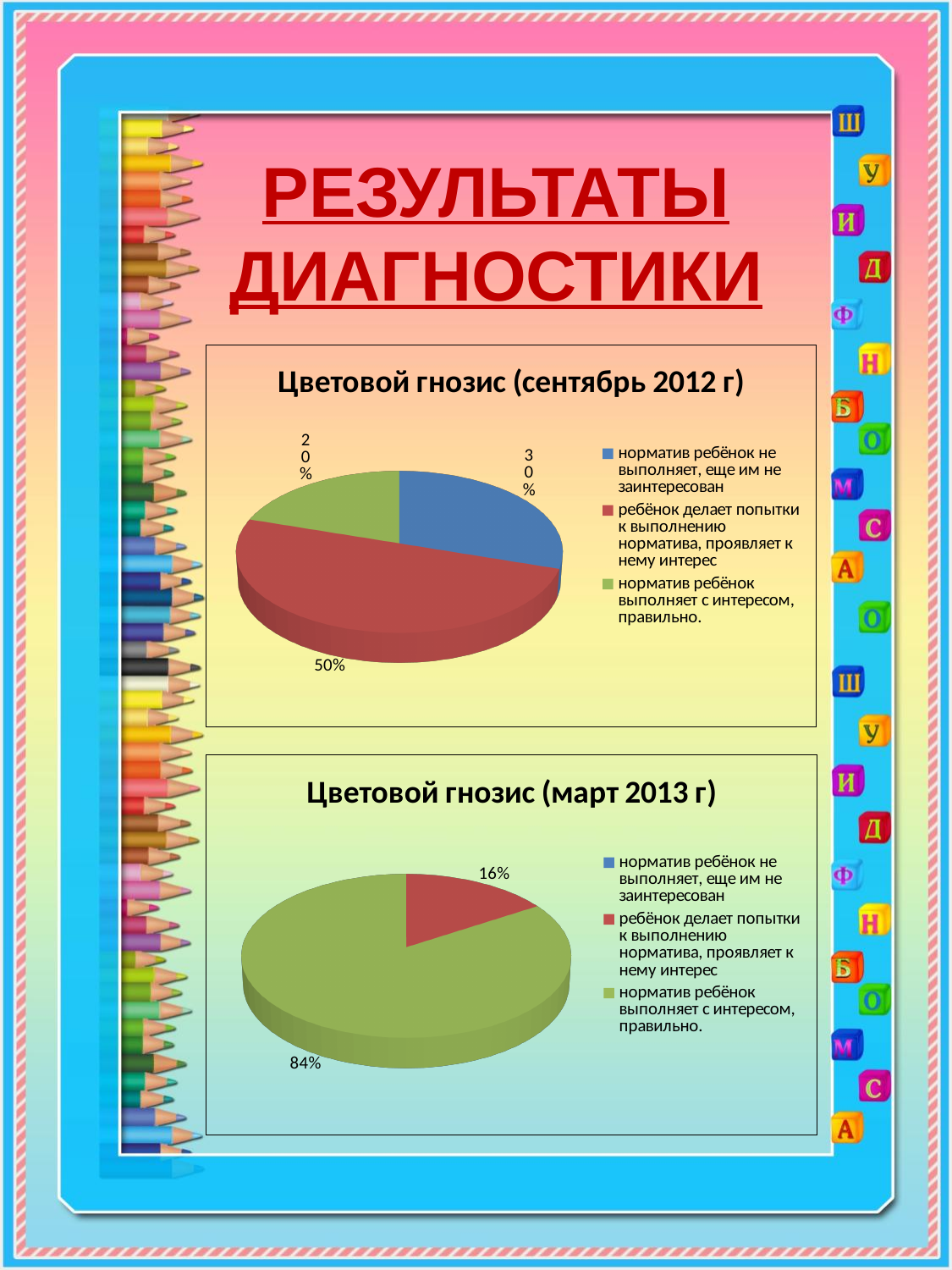
In the chart "Цветовой гнозис (март 2013 г)", what share is labelled for "норматив ребёнок выполняет с интересом, правильно."? 84% How many entries does the legend of the chart "Цветовой гнозис (март 2013 г)" list? 3 In the chart "Цветовой гнозис (март 2013 г)", which category has the largest slice? норматив ребёнок выполняет с интересом, правильно. What kind of chart is "Цветовой гнозис (сентябрь 2012 г)"? pie chart In the chart "Цветовой гнозис (сентябрь 2012 г)", which category has the smallest slice? норматив ребёнок выполняет с интересом, правильно. In the chart "Цветовой гнозис (март 2013 г)", what colour is the slice labelled 84%? green In the chart "Цветовой гнозис (сентябрь 2012 г)", what share is labelled for "норматив ребёнок выполняет с интересом, правильно."? 20% In the chart "Цветовой гнозис (сентябрь 2012 г)", which category has the largest slice? ребёнок делает попытки к выполнению норматива, проявляет к нему интерес In the chart "Цветовой гнозис (сентябрь 2012 г)", what share is labelled for "норматив ребёнок не выполняет, еще им не заинтересован"? 30% In the chart "Цветовой гнозис (март 2013 г)", what share is labelled for "ребёнок делает попытки к выполнению норматива, проявляет к нему интерес"? 16% In the chart "Цветовой гнозис (сентябрь 2012 г)", what share is labelled for "ребёнок делает попытки к выполнению норматива, проявляет к нему интерес"? 50% In the chart "Цветовой гнозис (сентябрь 2012 г)", what is the difference between the 50% slice and the 30% slice? 20%